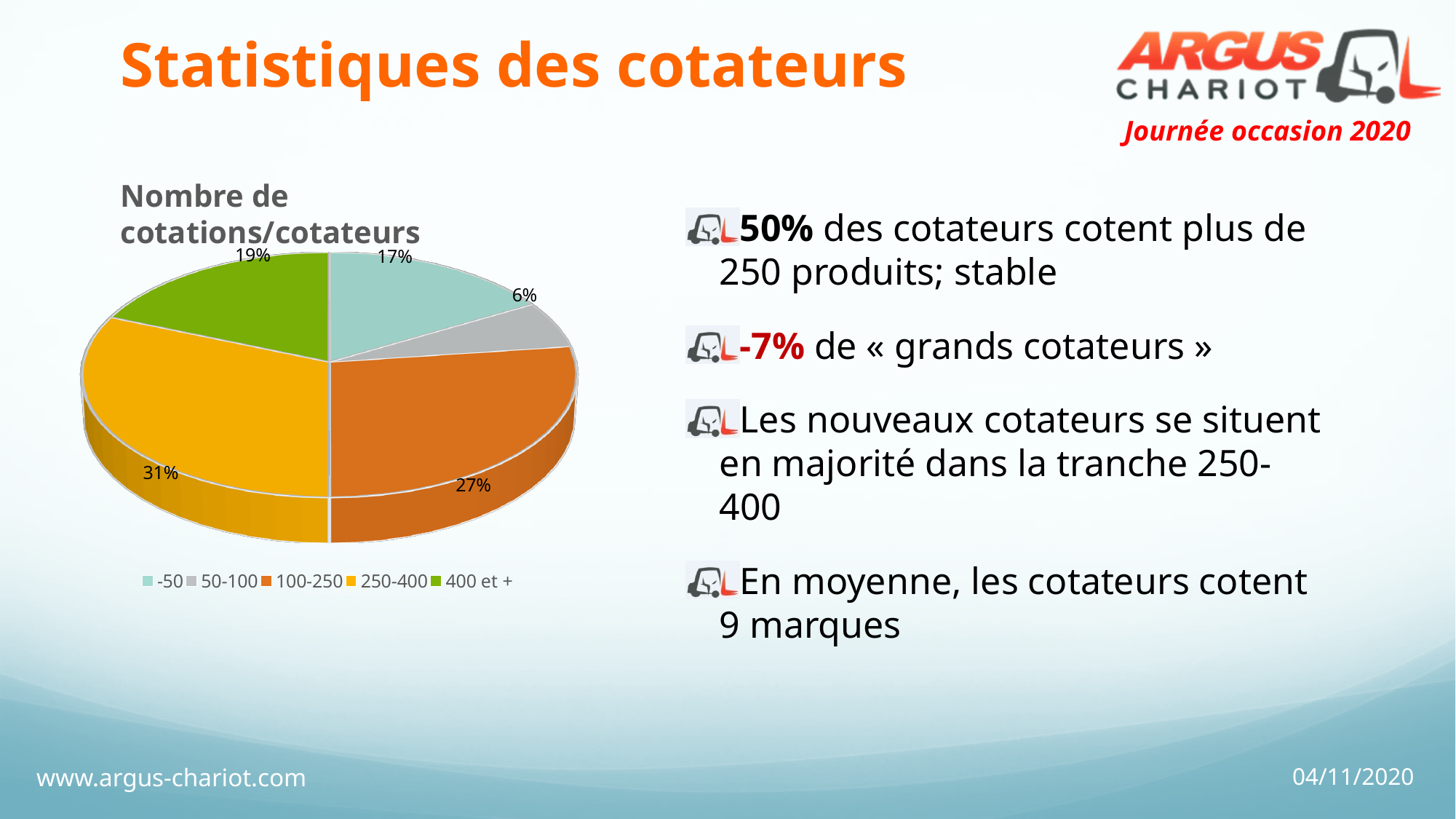
How many categories does the pie chart have? 5 What is the value shown for the 400 et + category? 19% What kind of chart is shown on the slide? Pie chart Which is larger, the share for -50 or the share for 400 et +? 400 et + What is the difference between the shares of the 250-400 and 100-250 categories? 4% What is the value shown for the -50 category? 17% What is the title of the chart? Nombre de cotations/cotateurs What is the value shown for the 50-100 category? 6% What is the value shown for the 100-250 category? 27% Which category has the smallest share of the pie? 50-100 Which category has the largest share of the pie? 250-400 What share of the pie does the 250-400 category represent? 31%